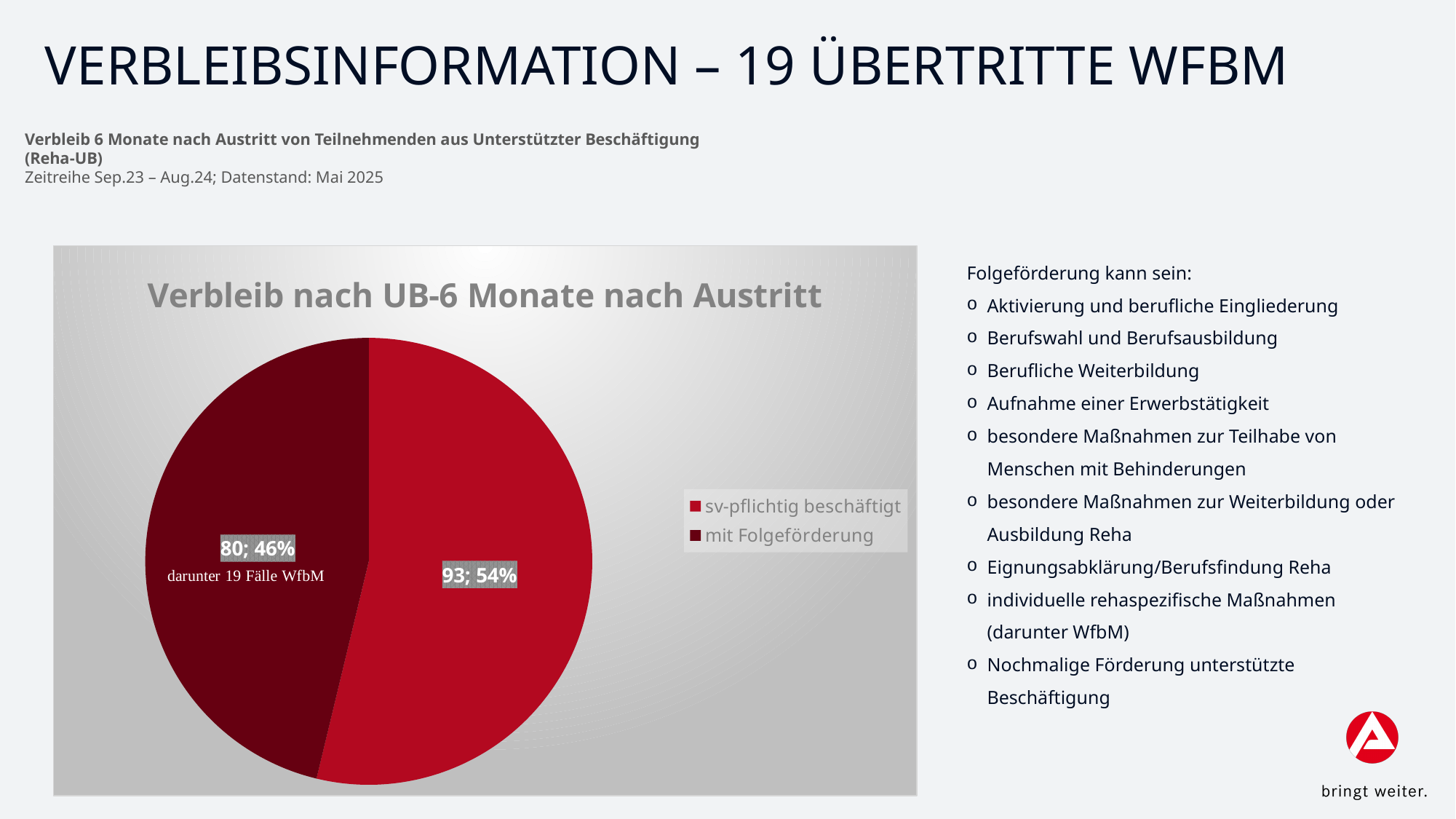
What share of the pie does 'sv-pflichtig beschäftigt' represent? 54% How many entries does the legend list? 2 What is the value for 'sv-pflichtig beschäftigt'? 93 What share of the pie does 'mit Folgeförderung' represent? 46% Which slice is the largest? sv-pflichtig beschäftigt Which slice is the smallest? mit Folgeförderung What is the title of the chart? Verbleib nach UB-6 Monate nach Austritt How many slices does the pie chart have? 2 How many cases of WfbM are noted within the 'mit Folgeförderung' slice? 19 What is the value for 'mit Folgeförderung'? 80 What kind of chart is shown on the slide? pie chart What is the difference between the values for 'sv-pflichtig beschäftigt' and 'mit Folgeförderung'? 13